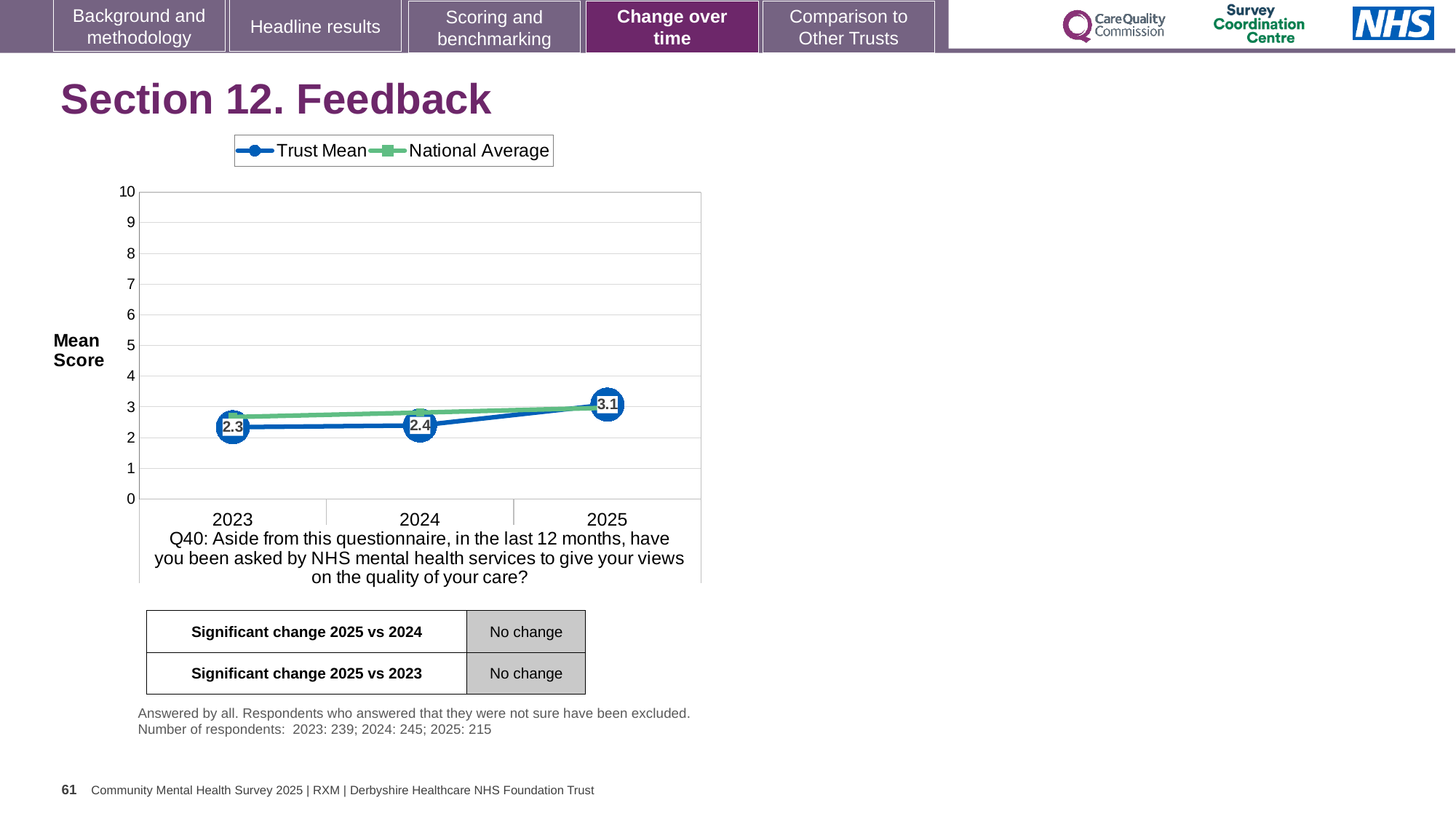
In which year is the Trust Mean lowest? 2023 What is the Trust Mean value for 2024? 2.4 In which year is the Trust Mean highest? 2025 What is the Trust Mean value for 2023? 2.3 In 2023, which is higher, the Trust Mean or the National Average? National Average What is the Trust Mean value for 2025? 3.1 Which is larger, the Trust Mean in 2025 or in 2024? 2025 What is the difference between the Trust Mean in 2025 and in 2023? 0.8 What kind of chart is shown on the slide? Line chart Is the National Average value for 2023 greater or less than 3? less How many years are plotted on the x axis? 3 How many series does the legend list? 2